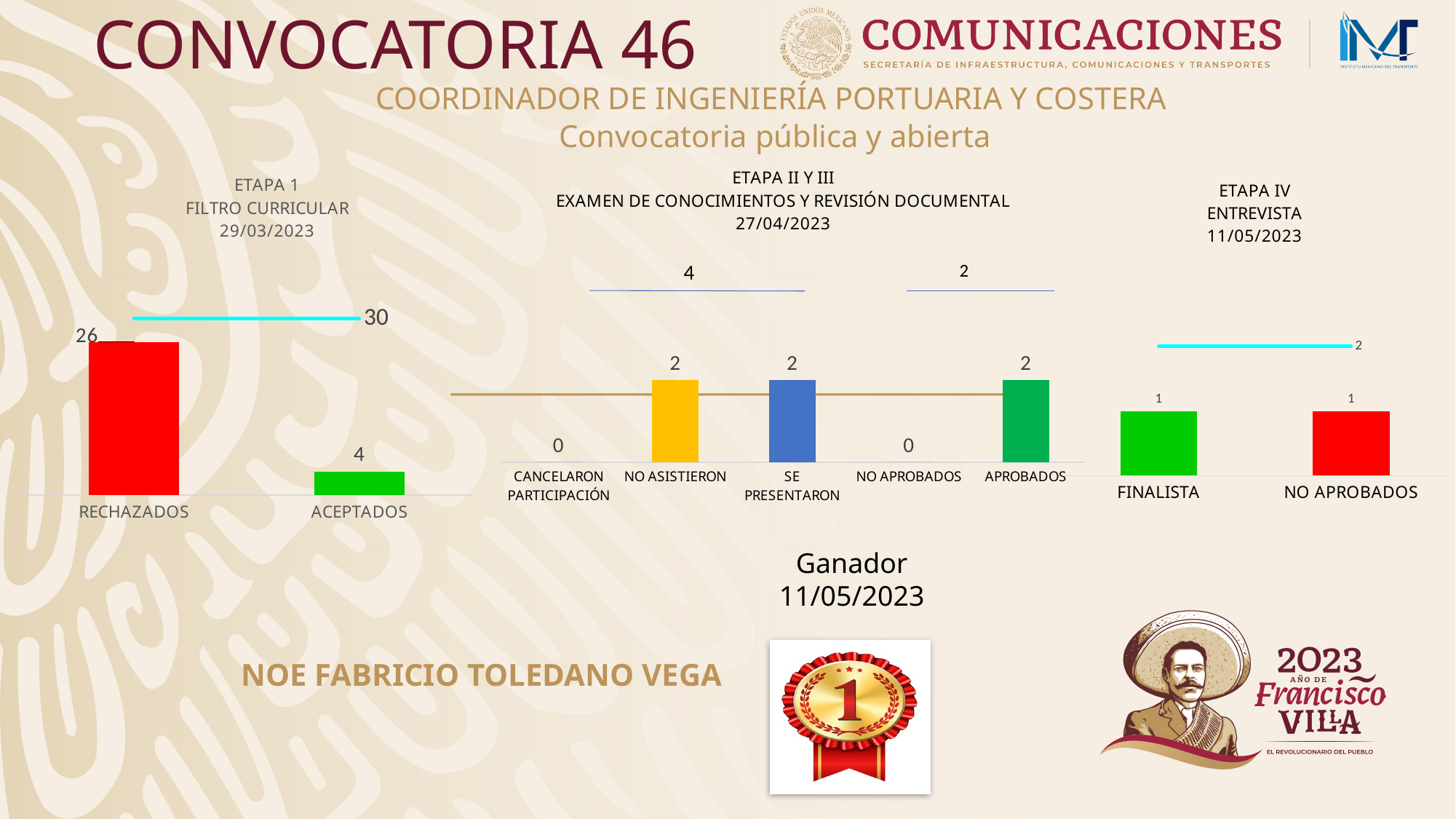
In the ETAPA 1 FILTRO CURRICULAR chart, which category is higher, RECHAZADOS or ACEPTADOS? RECHAZADOS In the ETAPA II Y III chart, what is the value for NO ASISTIERON? 2 In the ETAPA 1 FILTRO CURRICULAR chart, what is the value for ACEPTADOS? 4 In the ETAPA IV ENTREVISTA chart, what is the value for FINALISTA? 1 In the ETAPA 1 FILTRO CURRICULAR chart, what is the difference between RECHAZADOS and ACEPTADOS? 22 In the ETAPA 1 FILTRO CURRICULAR chart, what is the total of RECHAZADOS and ACEPTADOS? 30 In the ETAPA II Y III chart, how many categories are shown on the x axis? 5 What kind of chart is the ETAPA 1 FILTRO CURRICULAR chart? Combination bar and line chart In the ETAPA 1 FILTRO CURRICULAR chart, what is the value for RECHAZADOS? 26 In the ETAPA II Y III chart, what is the value for CANCELARON PARTICIPACIÓN? 0 In the ETAPA IV ENTREVISTA chart, what is the total of FINALISTA and NO APROBADOS? 2 In the ETAPA II Y III chart, what is the value for APROBADOS? 2